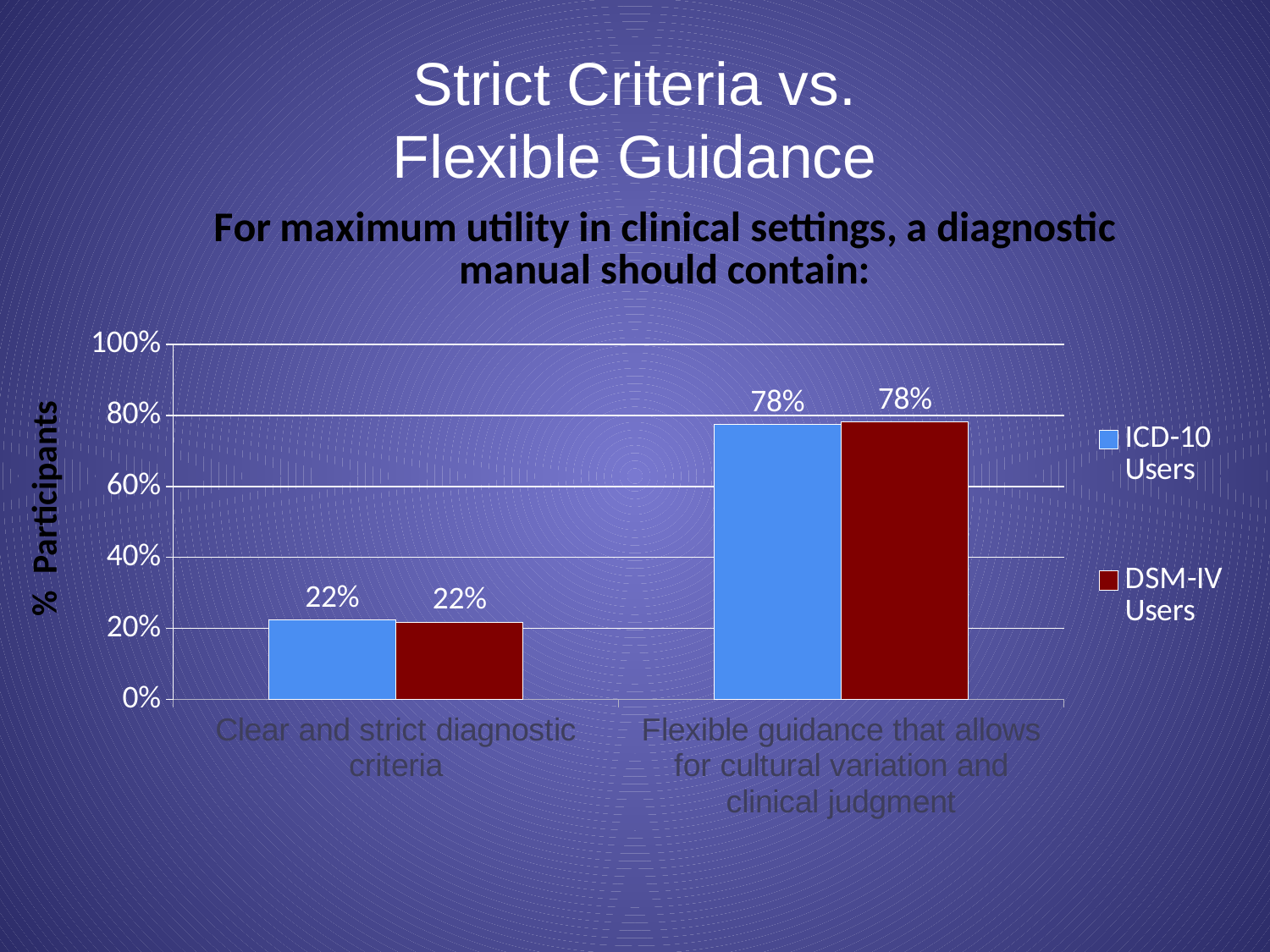
For ICD-10 Users, which option has the larger value: 'Clear and strict diagnostic criteria' or 'Flexible guidance that allows for cultural variation and clinical judgment'? Flexible guidance that allows for cultural variation and clinical judgment Is the value for DSM-IV Users on 'Flexible guidance' greater or less than 60%? greater Which option received the highest percentage among ICD-10 Users? Flexible guidance that allows for cultural variation and clinical judgment What kind of chart is shown on the slide? Bar chart Which option received the lowest percentage among DSM-IV Users? Clear and strict diagnostic criteria How many series does the legend list? 2 How many categories are shown on the x axis of the chart? 2 What percentage of DSM-IV Users chose 'Flexible guidance that allows for cultural variation and clinical judgment'? 78% What percentage of ICD-10 Users chose 'Clear and strict diagnostic criteria'? 22% What is the label of the y axis of the chart? % Participants What percentage of DSM-IV Users chose 'Clear and strict diagnostic criteria'? 22% What is the difference between the ICD-10 Users' percentages for 'Flexible guidance' and 'Clear and strict diagnostic criteria'? 56%